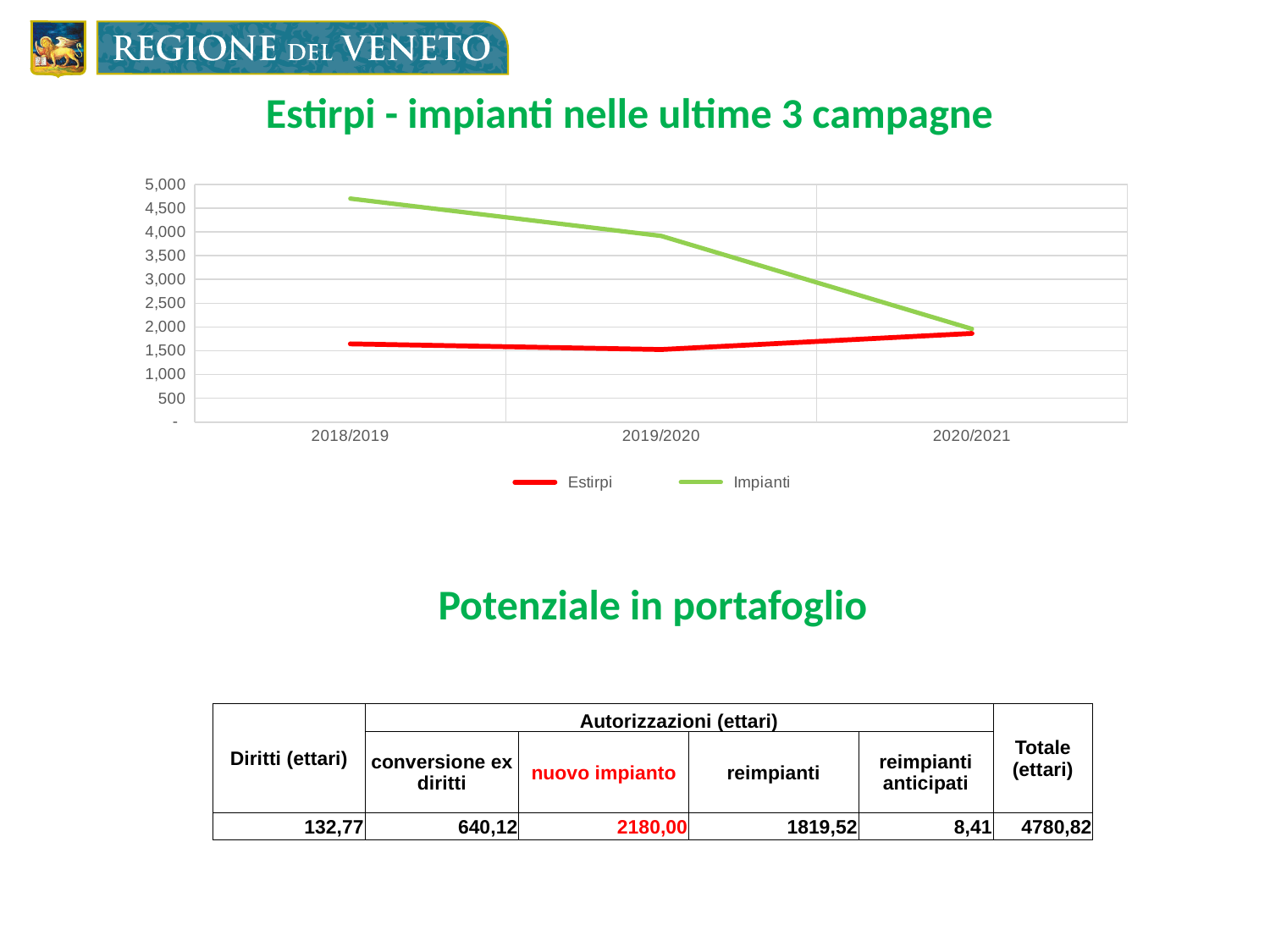
Is the Impianti value for 2018/2019 greater or less than 4,500? greater Is the Estirpi value for 2019/2020 greater or less than 2,000? less In which campaign is the Estirpi value highest? 2020/2021 In which campaign is the Impianti value lowest? 2020/2021 Which series is drawn in green on the chart? Impianti What is the title of the chart? Estirpi - impianti nelle ultime 3 campagne How many series does the chart legend list? 2 In which campaign is the Impianti value highest? 2018/2019 In 2018/2019, which series has the larger value, Estirpi or Impianti? Impianti How many campaigns (x-axis categories) are plotted on the chart? 3 Does the Impianti series rise or fall from 2018/2019 to 2020/2021? fall What kind of chart is shown on the slide? line chart